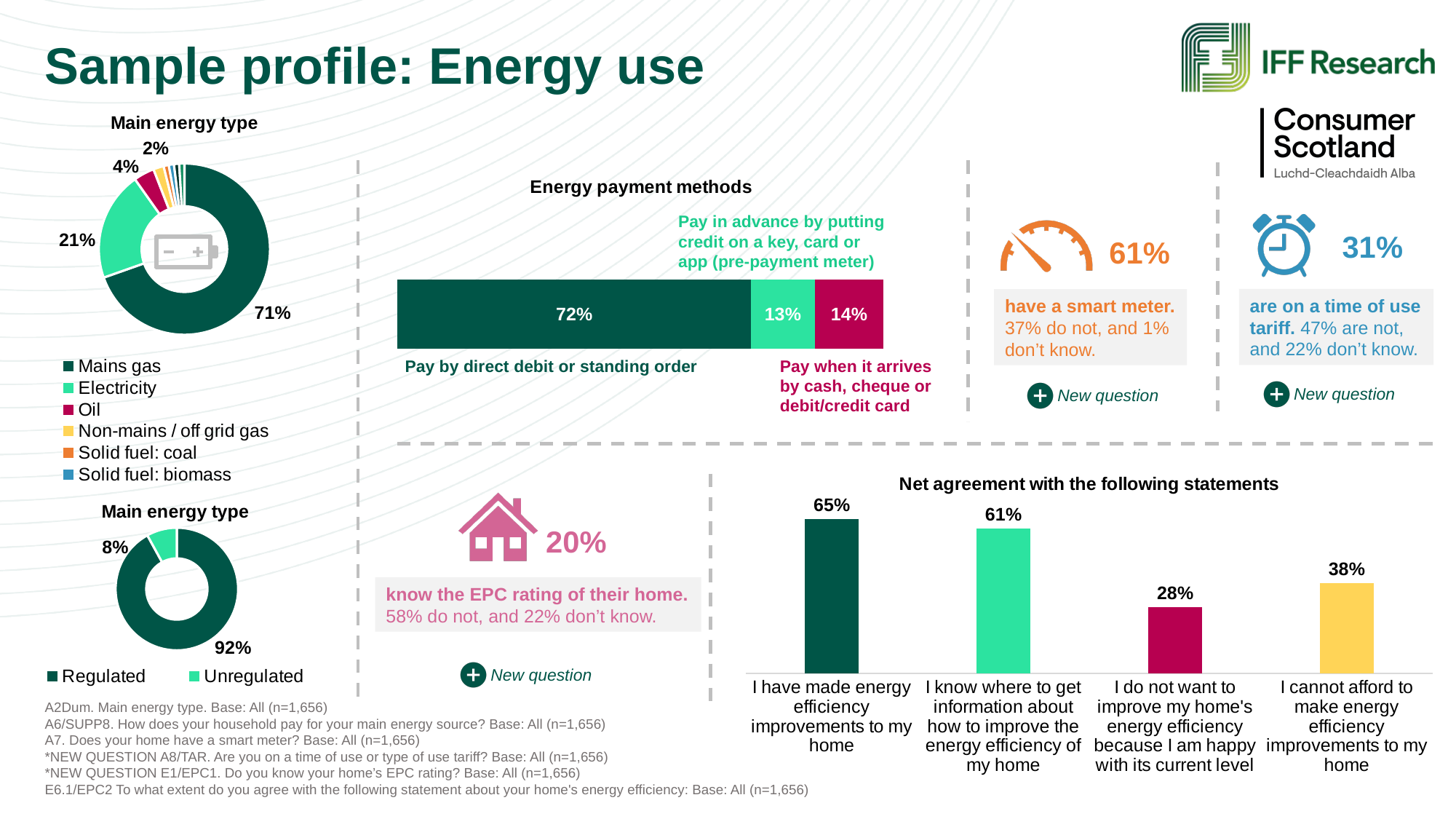
In the top-left 'Main energy type' donut chart, what share is Mains gas? 71% In the top-left 'Main energy type' donut chart, what share is Electricity? 21% In the top-left 'Main energy type' donut chart, which energy type has the largest share? Mains gas In the bottom-left 'Main energy type' donut chart, what share is Unregulated? 8% In the 'Net agreement with the following statements' chart, which statement has the lowest net agreement? I do not want to improve my home's energy efficiency because I am happy with its current level What kind of chart is 'Net agreement with the following statements'? Bar chart How many entries does the legend of the top-left 'Main energy type' donut chart list? 6 In the 'Net agreement with the following statements' chart, what is the value for 'I cannot afford to make energy efficiency improvements to my home'? 38% In the 'Energy payment methods' stacked bar, which is larger: pre-payment meter or paying when it arrives by cash, cheque or debit/credit card? Pay when it arrives by cash, cheque or debit/credit card In the 'Energy payment methods' stacked bar, what percentage pay by direct debit or standing order? 72% In the 'Net agreement with the following statements' chart, what is the difference between 'I have made energy efficiency improvements to my home' and 'I know where to get information about how to improve the energy efficiency of my home'? 4% In the bottom-left 'Main energy type' donut chart, what is the difference between the Regulated and Unregulated shares? 84%